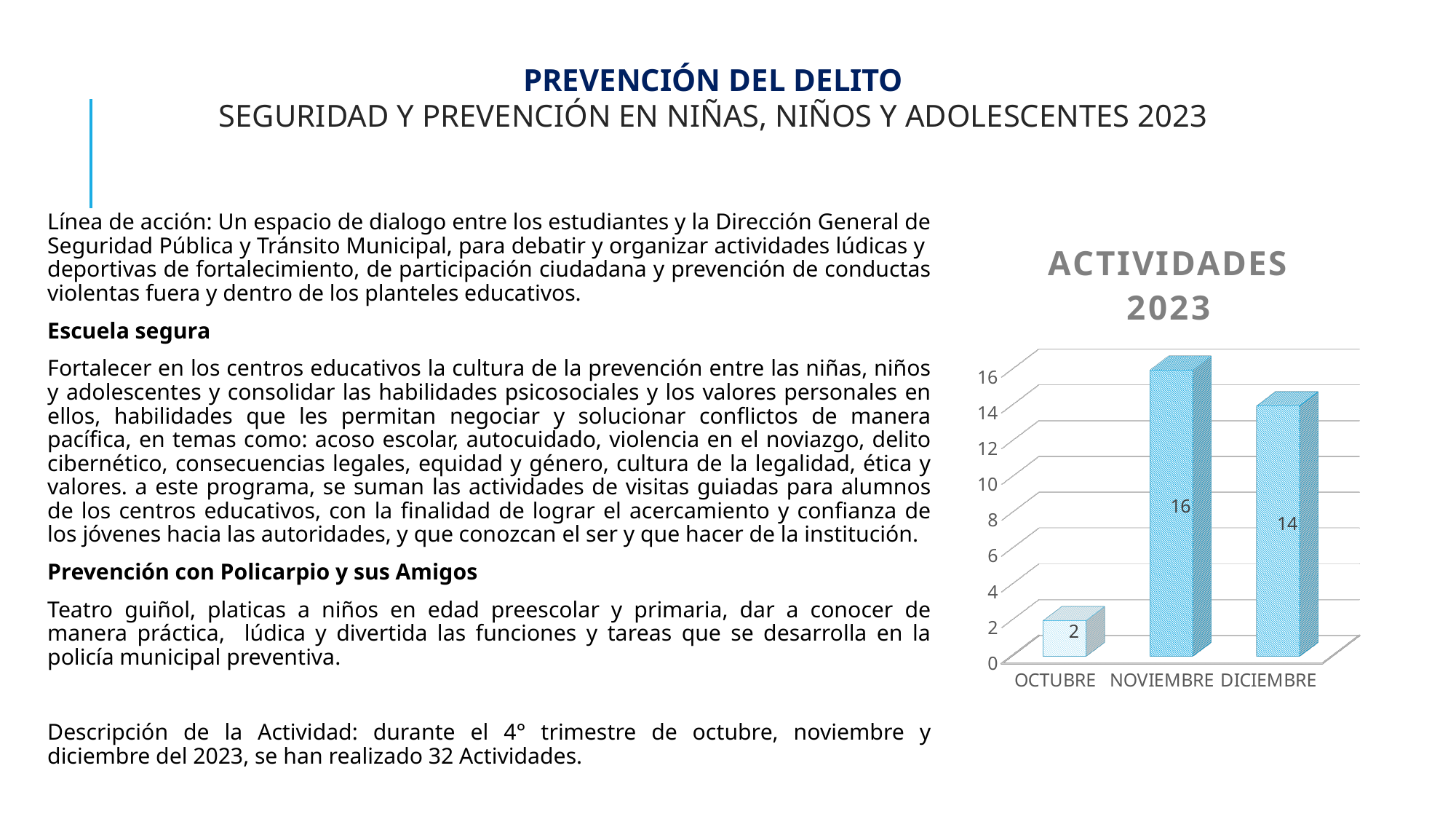
What is the value for NOVIEMBRE in the ACTIVIDADES 2023 chart? 16 How many months are shown on the x axis of the ACTIVIDADES 2023 chart? 3 Is the value for DICIEMBRE greater or less than 10? greater What is the difference between the values for NOVIEMBRE and OCTUBRE? 14 Which month has the highest value in the ACTIVIDADES 2023 chart? NOVIEMBRE What is the difference between the values for NOVIEMBRE and DICIEMBRE? 2 Which is larger, the value for DICIEMBRE or the value for OCTUBRE? DICIEMBRE What is the value for DICIEMBRE in the ACTIVIDADES 2023 chart? 14 What is the value for OCTUBRE in the ACTIVIDADES 2023 chart? 2 What is the title of the chart on the slide? ACTIVIDADES 2023 Which month has the lowest value in the ACTIVIDADES 2023 chart? OCTUBRE What kind of chart is the ACTIVIDADES 2023 chart? Bar chart